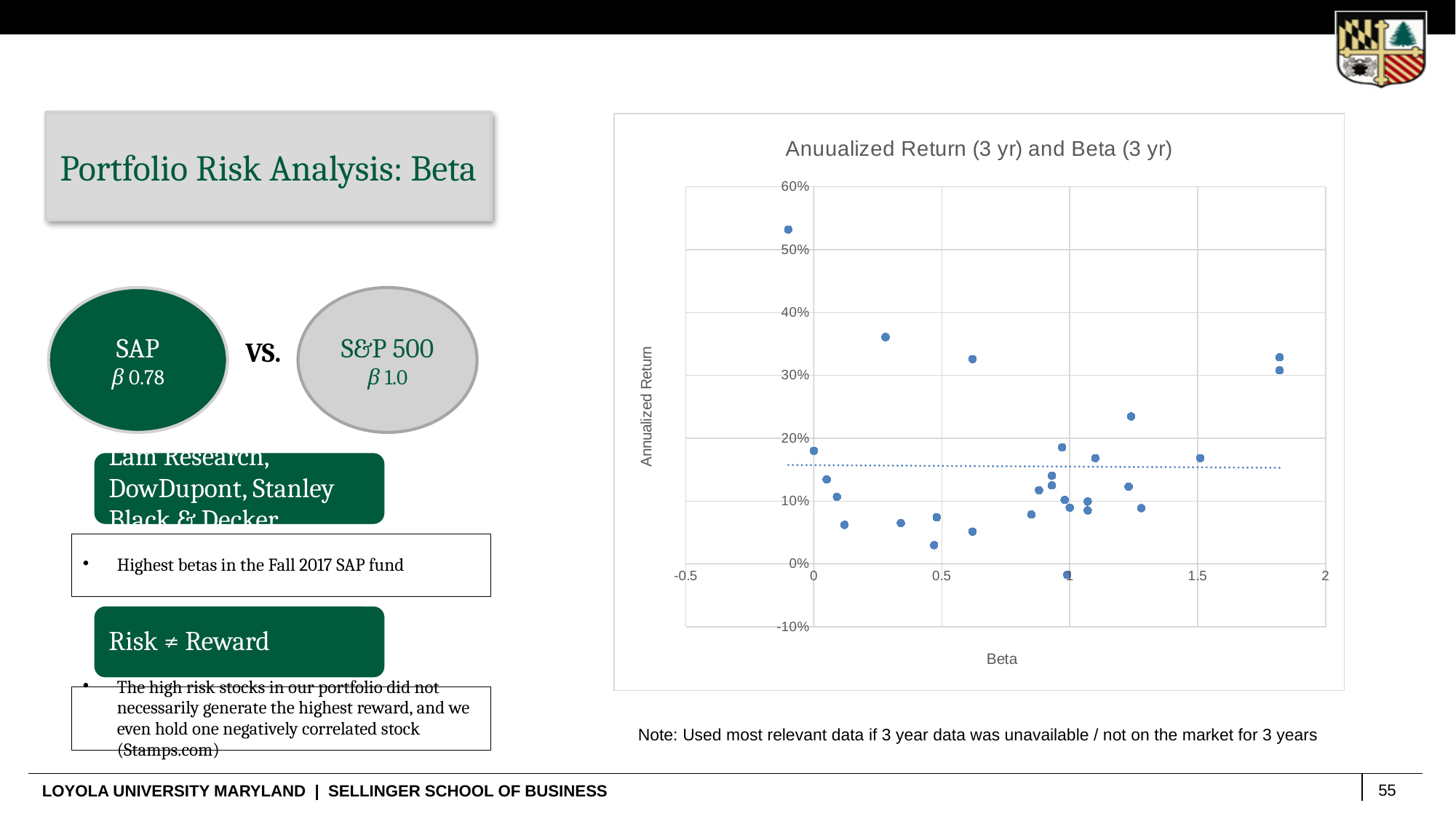
Is the beta of the point with a return of about 36% greater or less than 0.5? less What kind of chart is shown on the slide? Scatter chart What is the title of the chart? Anuualized Return (3 yr) and Beta (3 yr) What is the lowest value shown on the horizontal axis of the chart? -0.5 Are the annualized returns of the points with the highest beta (right-most points, near 1.8) greater or less than 20%? greater Is the beta of the highest-return point on the chart greater or less than 0.5? less What is the highest value shown on the vertical axis of the chart? 60%